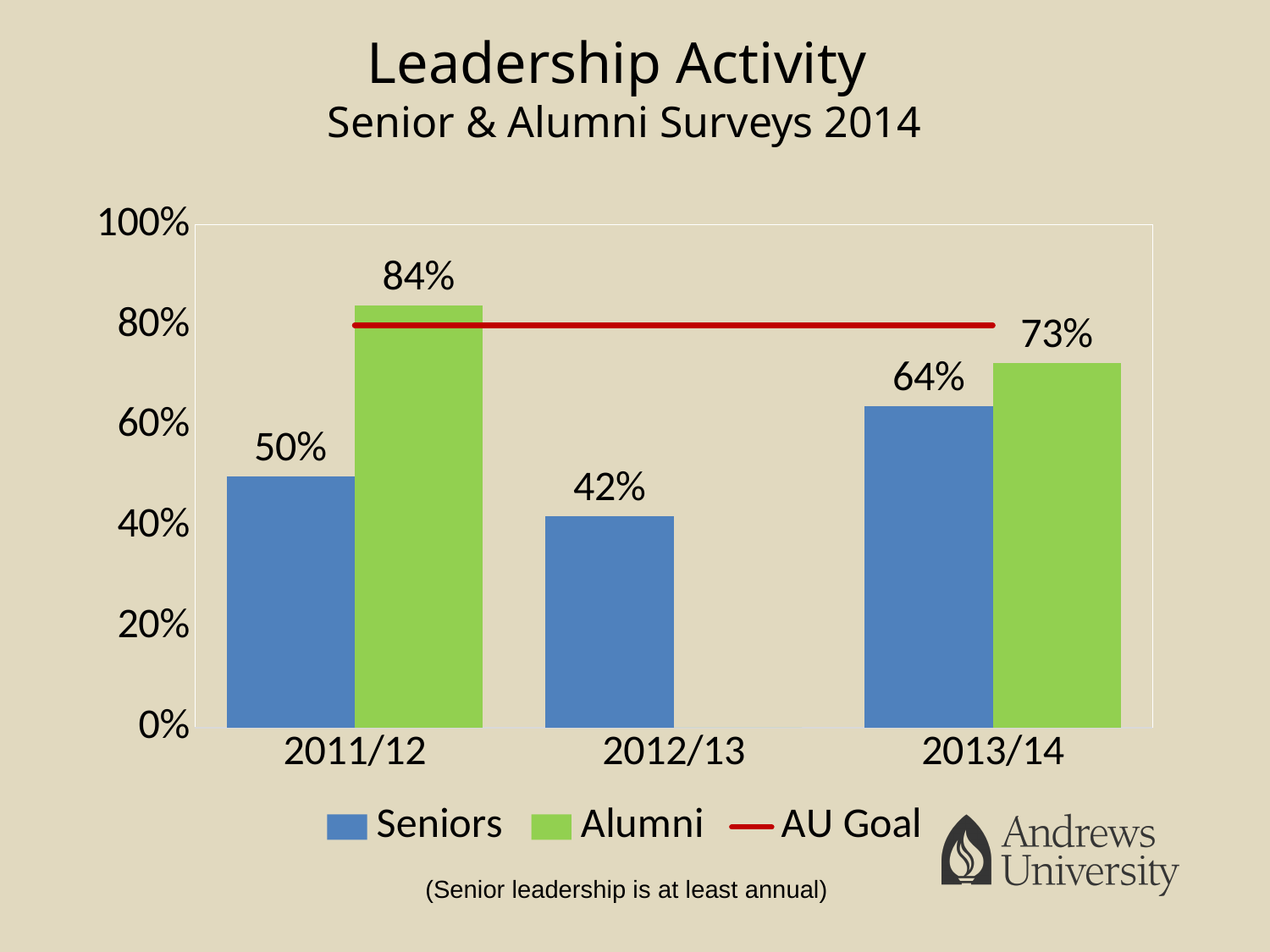
Which is larger, the Seniors value for 2013/14 or the Alumni value for 2013/14? Alumni value for 2013/14 How many entries does the legend list? 3 What is the difference between the Seniors values for 2013/14 and 2012/13? 22% Which year has the highest Alumni value? 2011/12 How many year categories are shown on the x axis? 3 Is the AU Goal line greater or less than 60%? greater What is the Seniors value for 2011/12? 50% What is the difference between the Alumni and Seniors values for 2011/12? 34% What is the Alumni value for 2013/14? 73% What is the Seniors value for 2012/13? 42% Which year has the lowest Seniors value? 2012/13 What kind of chart is shown on the slide? Combination bar and line chart